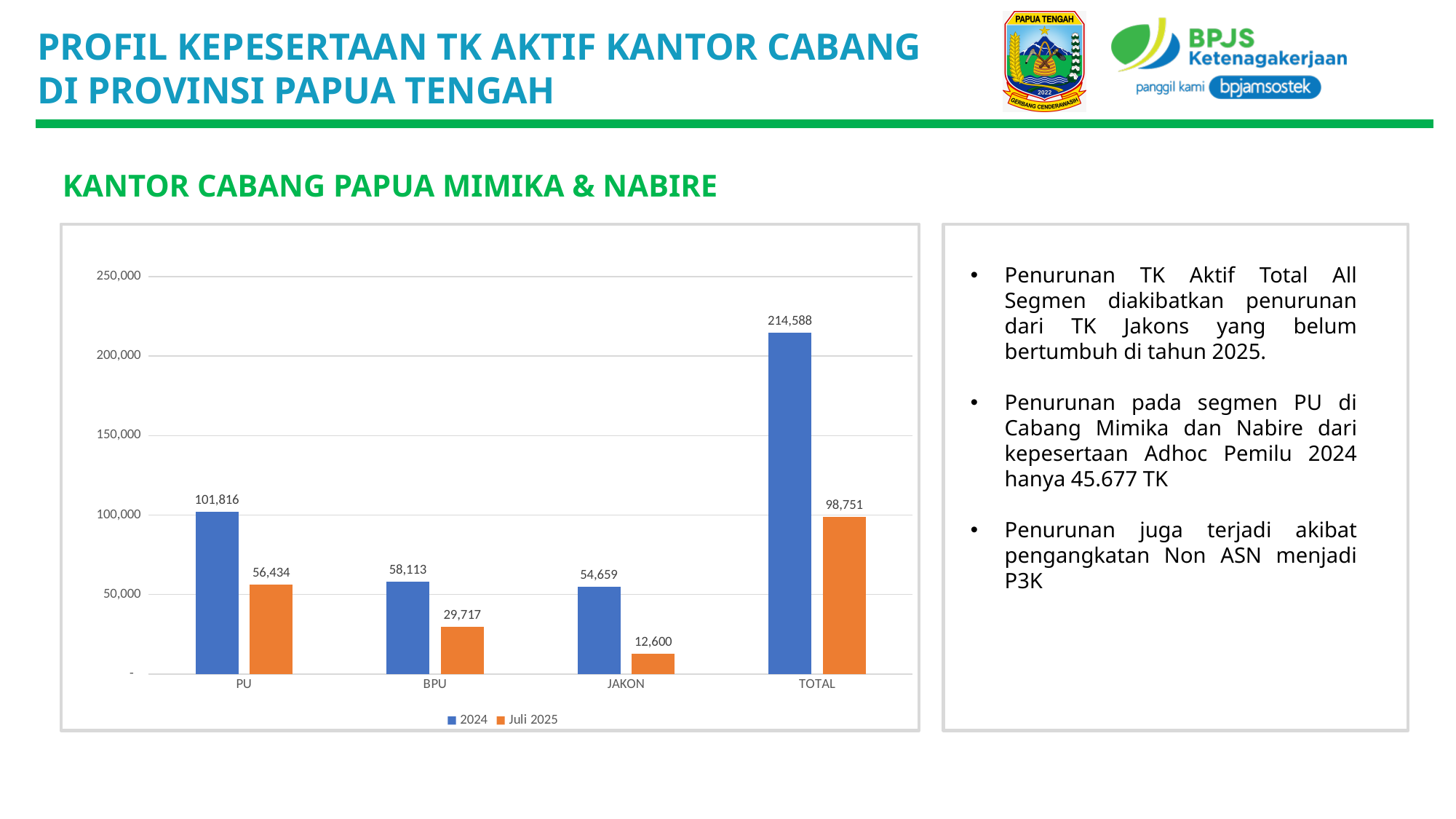
Which is larger: the 2024 value for BPU or the 2024 value for JAKON? BPU What is the difference between the 2024 and Juli 2025 values for TOTAL? 115,837 How many series does the legend list? 2 What is the value for BPU in the Juli 2025 series? 29,717 What kind of chart is shown on the slide? Bar chart Excluding TOTAL, which category has the lowest value in the Juli 2025 series? JAKON What is the value for PU in the 2024 series? 101,816 What is the value for JAKON in the Juli 2025 series? 12,600 Excluding TOTAL, which category has the highest value in the 2024 series? PU What is the difference between the 2024 and Juli 2025 values for PU? 45,382 What is the value for TOTAL in the 2024 series? 214,588 How many categories are shown on the x axis? 4